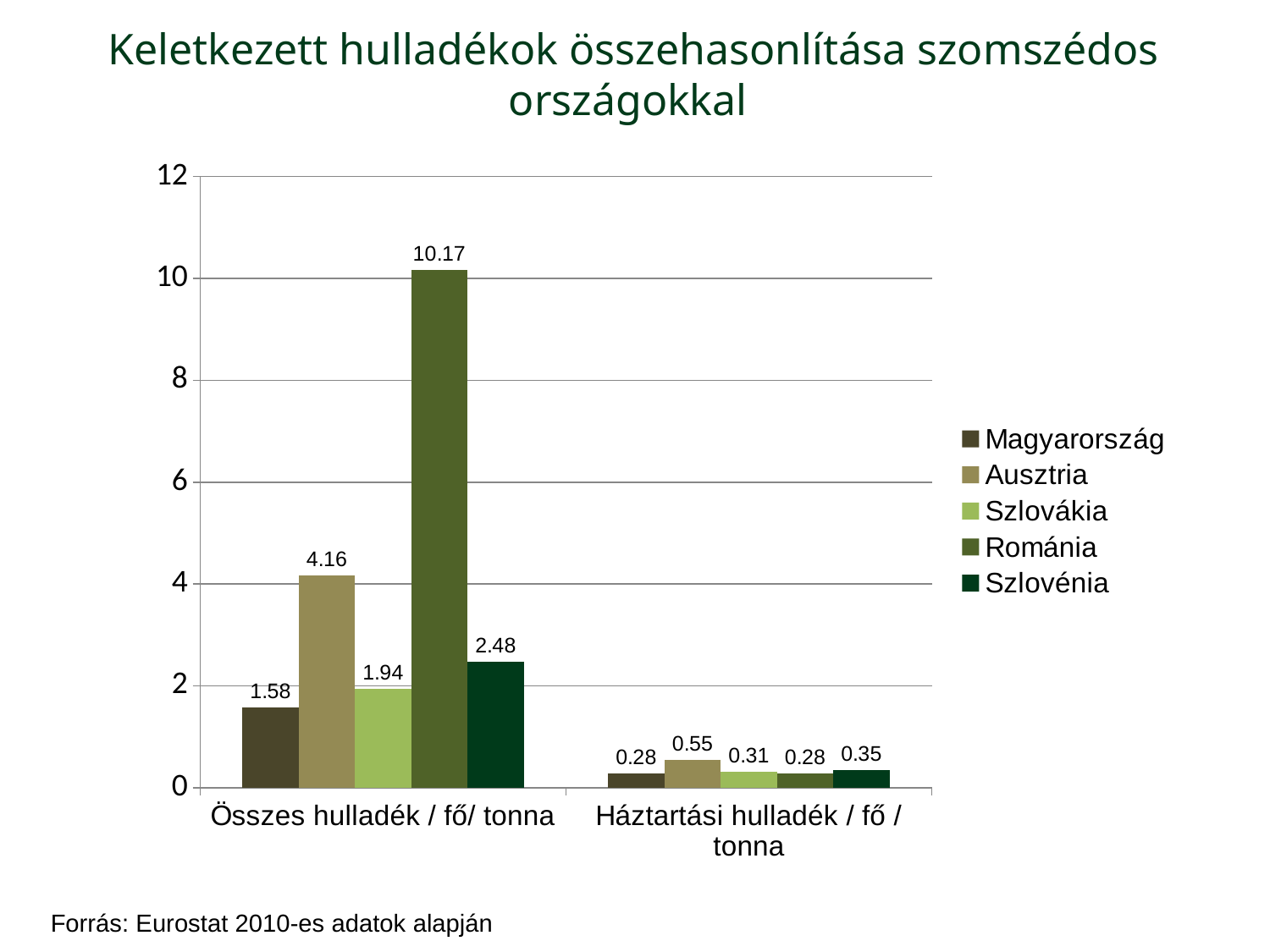
What kind of chart is shown on the slide? Bar chart Is the value for Ausztria in the "Összes hulladék / fő/ tonna" category greater or less than 4? greater How many series does the legend list? 5 Which country has the highest value in the "Háztartási hulladék / fő / tonna" category? Ausztria What is the value for Románia in the "Összes hulladék / fő/ tonna" category? 10.17 Which country has the highest value in the "Összes hulladék / fő/ tonna" category? Románia What is the difference between Románia and Ausztria in the "Összes hulladék / fő/ tonna" category? 6.01 How many categories are shown on the x axis? 2 What is the value for Magyarország in the "Összes hulladék / fő/ tonna" category? 1.58 Which is larger in the "Összes hulladék / fő/ tonna" category: Szlovénia or Szlovákia? Szlovénia Which country has the lowest value in the "Összes hulladék / fő/ tonna" category? Magyarország What is the value for Ausztria in the "Háztartási hulladék / fő / tonna" category? 0.55